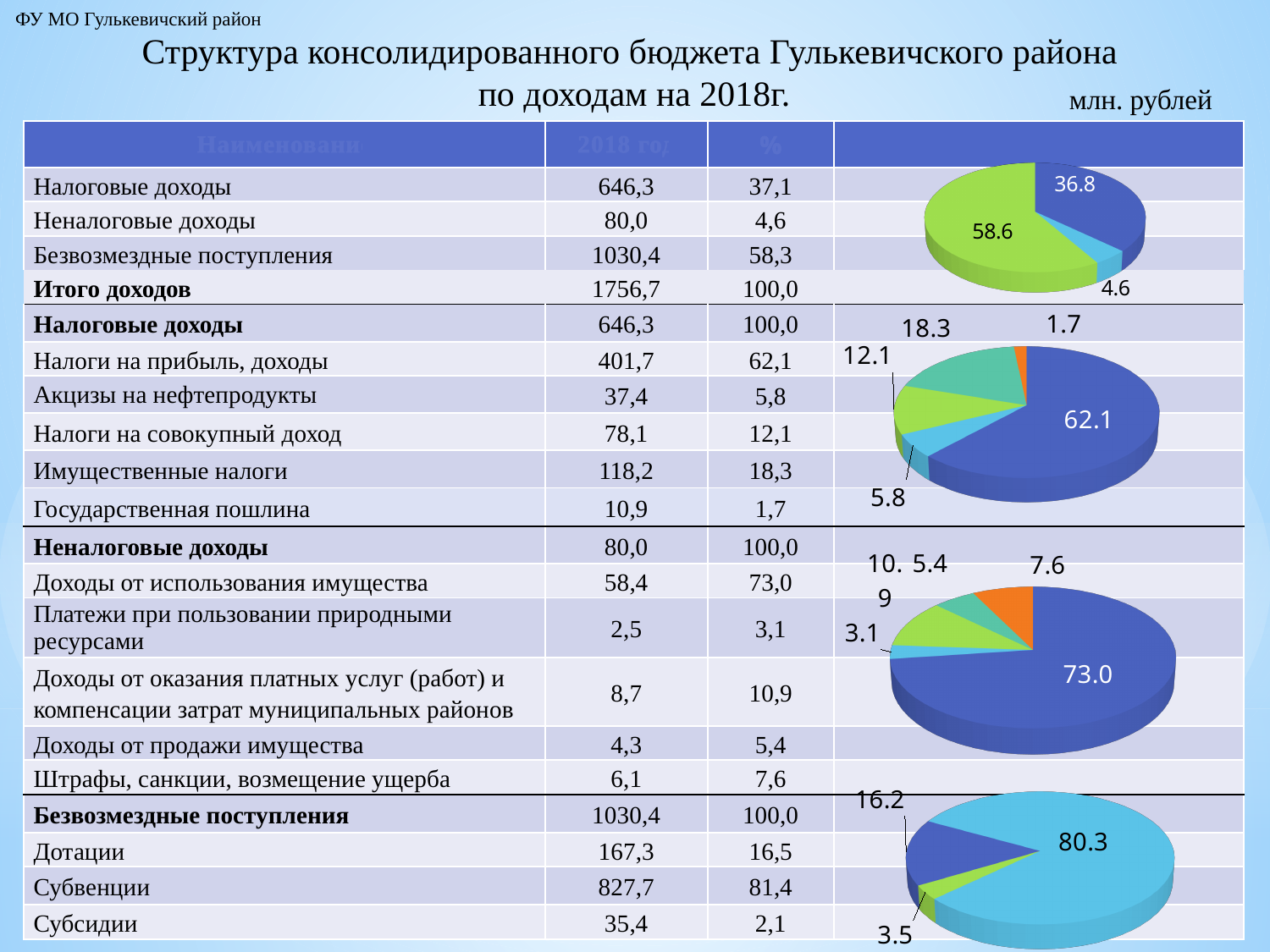
How many slices does the top pie chart have? 3 In the bottom pie chart, what is the difference between the slice labelled 16.2 and the slice labelled 3.5? 12.7 What type of chart is the top chart on the slide? pie chart In the top pie chart, what is the value of the smallest slice? 4.6 In the bottom pie chart, what is the value of the largest slice? 80.3 In the third pie chart from the top, which is larger: the slice labelled 7.6 or the slice labelled 5.4? 7.6 How many slices does the second pie chart from the top have? 5 In the second pie chart from the top, what is the difference between the largest slice (62.1) and the slice labelled 18.3? 43.8 In the second pie chart from the top, what is the value of the smallest slice? 1.7 In the third pie chart from the top, what is the value of the largest slice? 73.0 In the second pie chart from the top, what is the value of the largest slice? 62.1